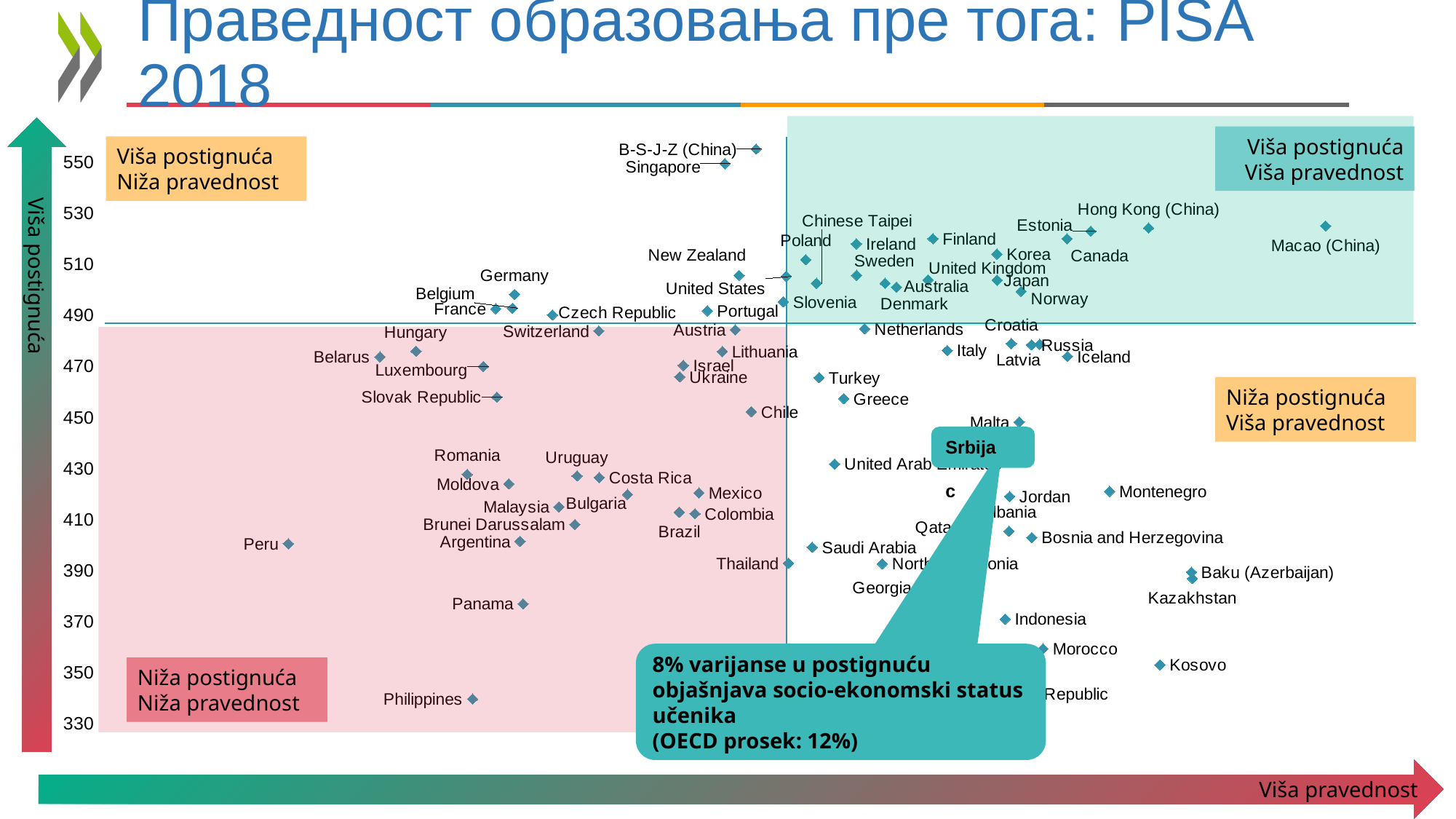
What label is written in the top-right quadrant box of the chart? Viša postignuća Viša pravednost Which country or economy has the highest value on the vertical axis? B-S-J-Z (China) Is the vertical-axis value for Philippines greater or less than 350? less Which is higher on the vertical axis, Chile or Mexico? Chile Which country has the lowest value on the vertical axis? Philippines Which is higher on the vertical axis, Peru or Panama? Peru Is the vertical-axis value for Montenegro greater or less than 410? greater Is the vertical-axis value for Slovak Republic greater or less than 470? less What kind of chart is shown on the slide? scatter chart Which is higher on the vertical axis, Singapore or Macao (China)? Singapore